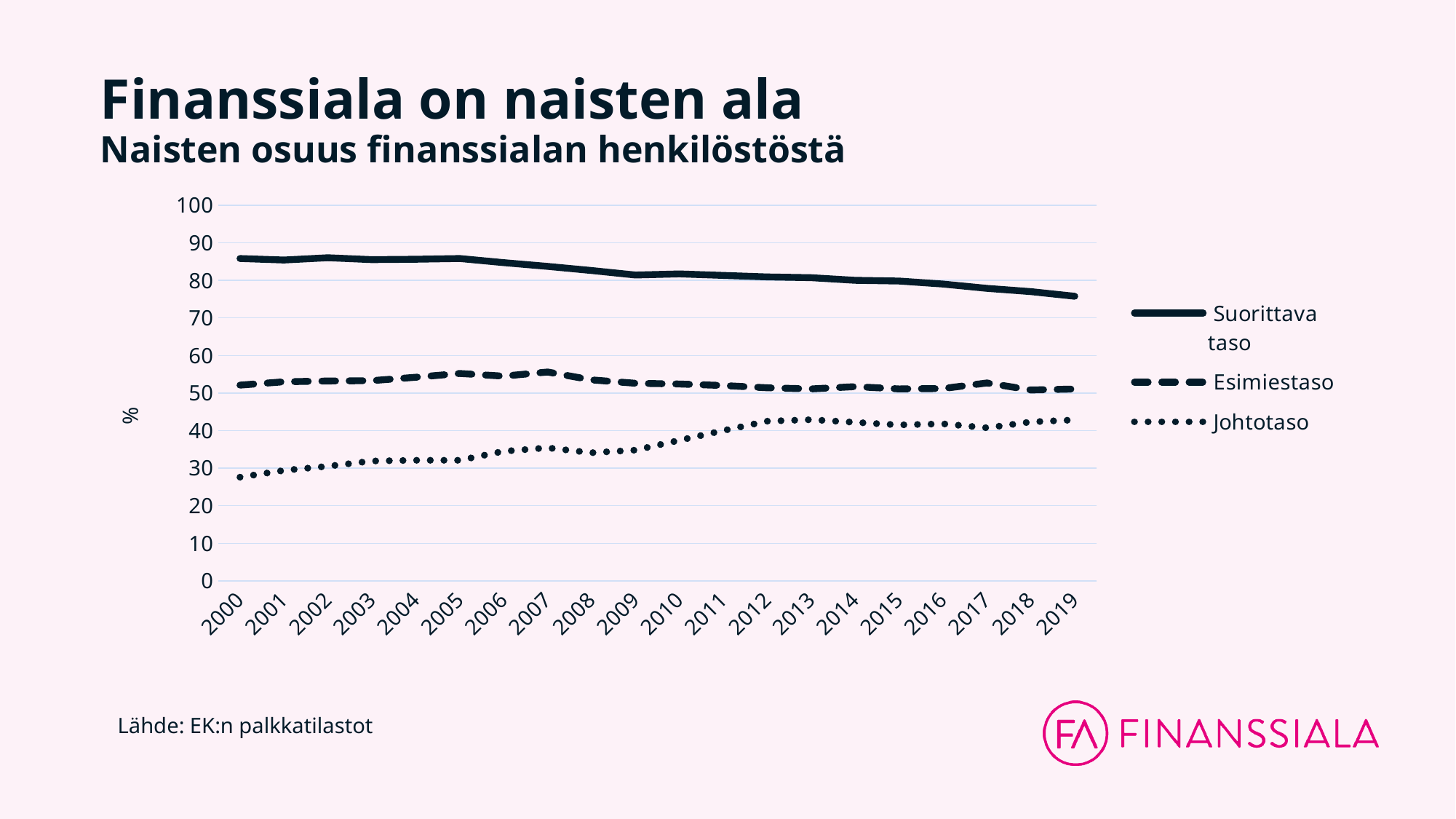
In which year is the Johtotaso value lowest? 2000 Which series has the highest value in 2019? Suorittava taso What kind of chart is shown on the slide? line chart What is the subtitle of the chart? Naisten osuus finanssialan henkilöstöstä Is the value for Johtotaso in 2000 greater or less than 30? less Does the Johtotaso line rise or fall from 2000 to 2019? rise How many series does the legend list? 3 Does the Suorittava taso line rise or fall from 2000 to 2019? fall Is the value for Suorittava taso in 2000 greater or less than 80? greater Is the value for Suorittava taso in 2019 greater or less than 80? less In 2010, which is larger: Esimiestaso or Johtotaso? Esimiestaso How many years are shown on the x axis? 20